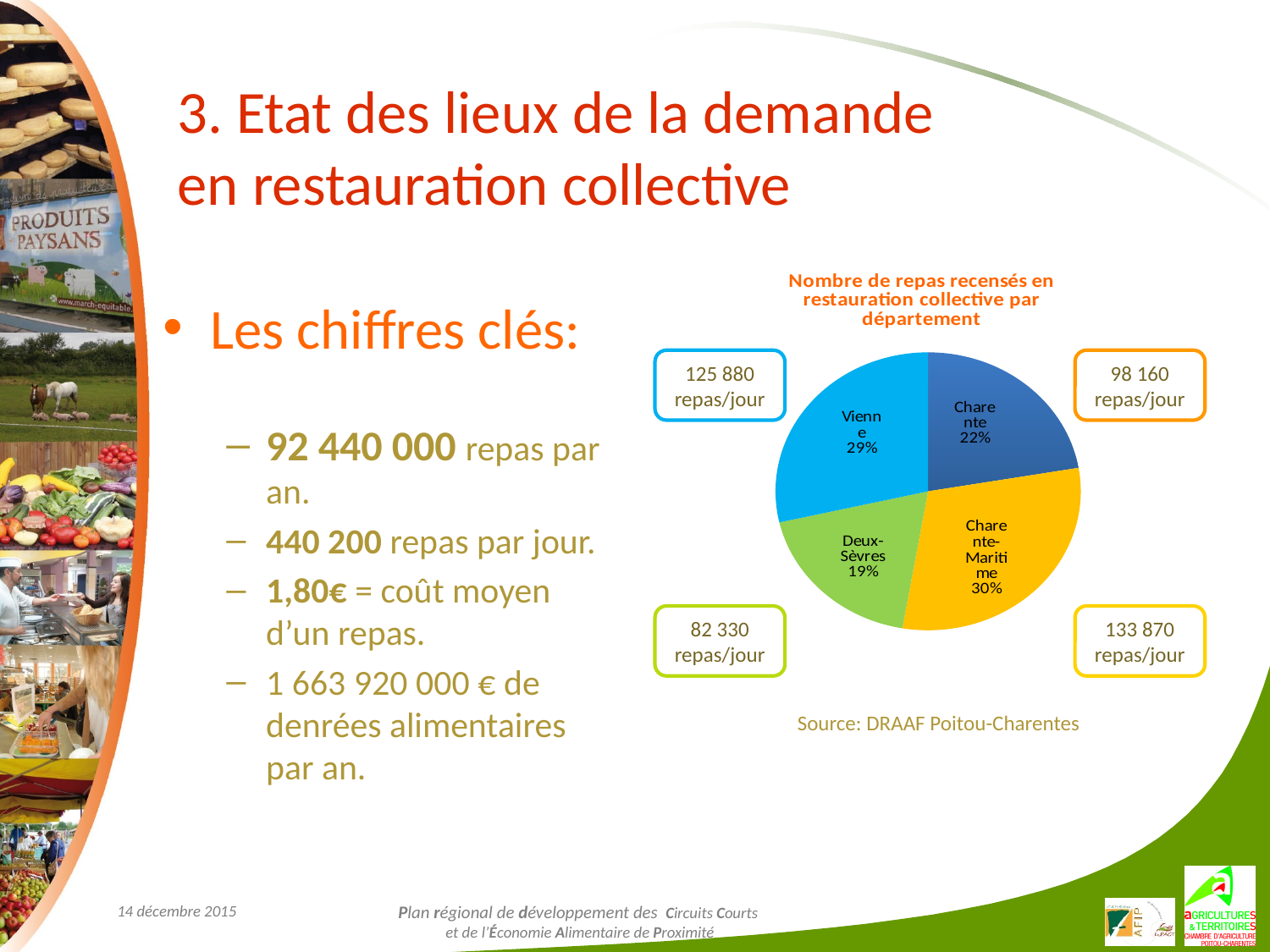
Which department has the smallest share of the pie? Deux-Sèvres What kind of chart is shown on the slide? pie chart Which has a larger share of the pie, Charente or Deux-Sèvres? Charente What share of the pie does Vienne represent? 29% What share of the pie does Charente represent? 22% What is the title of the pie chart? Nombre de repas recensés en restauration collective par département What share of the pie does Deux-Sèvres represent? 19% How many departments (slices) does the pie chart show? 4 What is the difference in percentage points between the Charente-Maritime and Deux-Sèvres shares? 11 What source is cited below the pie chart? DRAAF Poitou-Charentes Which department has the largest share of the pie? Charente-Maritime